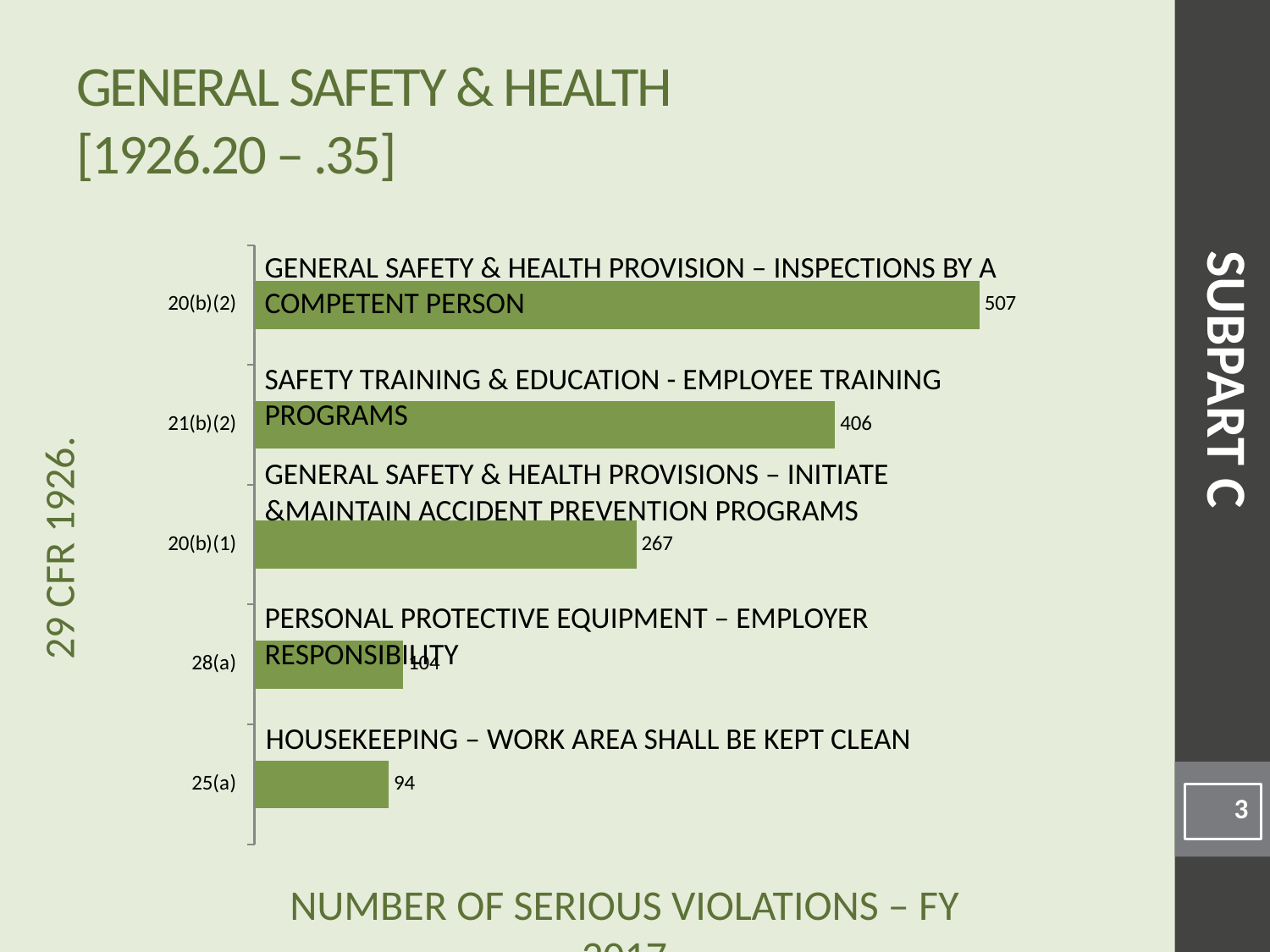
What kind of chart is shown on the slide? Bar chart What is the difference between the values for 21(b)(2) and 20(b)(1)? 139 Which category has the lowest number of serious violations? 25(a) Which category has the highest number of serious violations? 20(b)(2) What is the number of serious violations for 20(b)(1)? 267 How many categories are shown in the chart? 5 Which category is labeled "HOUSEKEEPING – WORK AREA SHALL BE KEPT CLEAN"? 25(a) What is the number of serious violations for 25(a)? 94 Which has more serious violations, 20(b)(1) or 25(a)? 20(b)(1) What is the number of serious violations for 21(b)(2)? 406 What is the difference between the values for 20(b)(2) and 21(b)(2)? 101 What is the number of serious violations for 20(b)(2)? 507